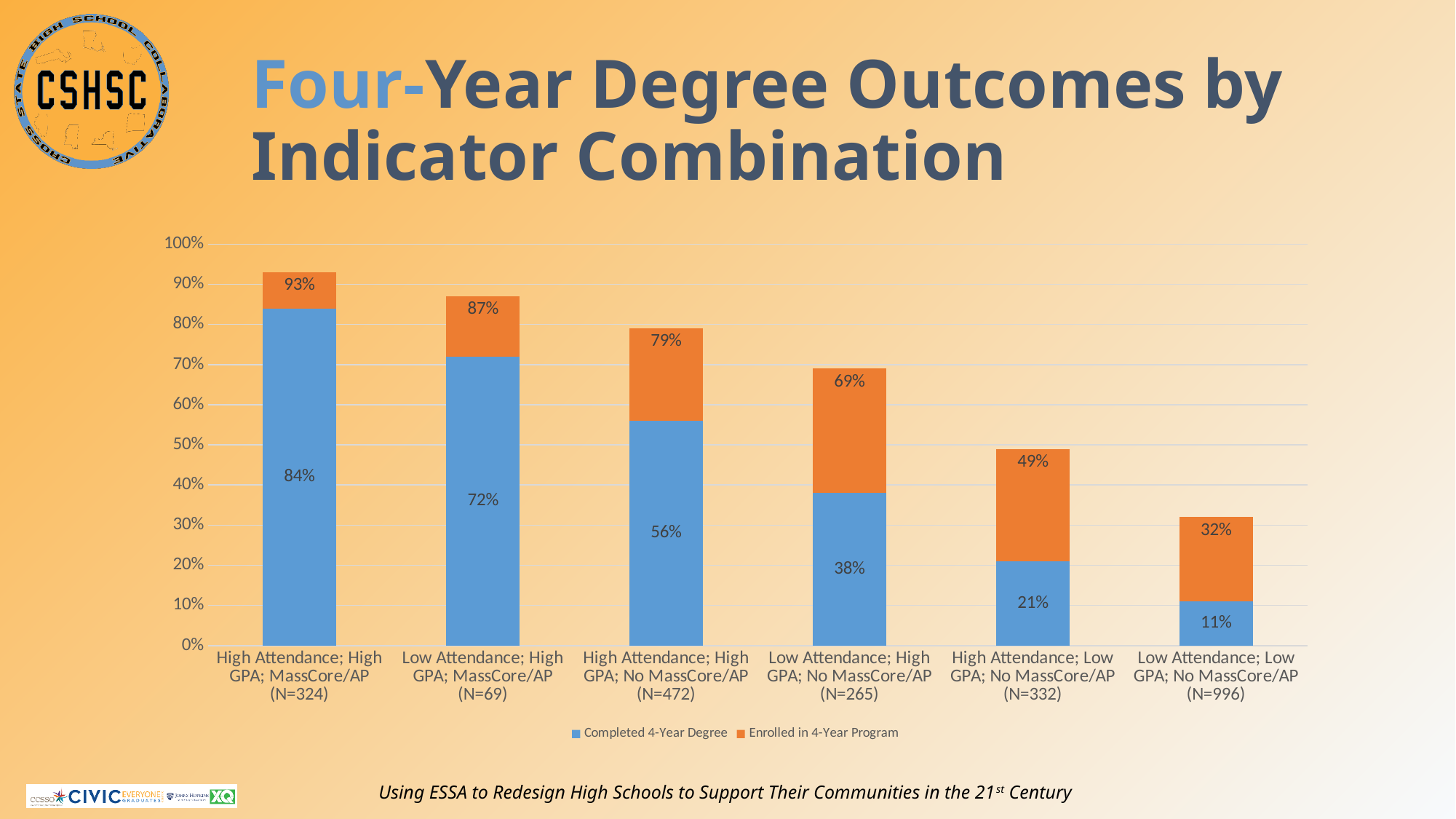
How many series does the legend list? 2 How many indicator combination categories are shown on the x axis? 6 Do the total bar heights rise or fall moving from left to right across the x axis? Fall Which group has a larger Completed 4-Year Degree percentage: High Attendance; Low GPA; No MassCore/AP (N=332) or Low Attendance; High GPA; No MassCore/AP (N=265)? Low Attendance; High GPA; No MassCore/AP (N=265) Which indicator combination has the highest percentage of students who completed a 4-year degree? High Attendance; High GPA; MassCore/AP (N=324) What is the total height of the stacked bar for High Attendance; High GPA; No MassCore/AP (N=472)? 79% What percentage of the Low Attendance; High GPA; MassCore/AP (N=69) group completed a 4-year degree? 72% What kind of chart is shown on the slide? Stacked bar chart What percentage of the Low Attendance; Low GPA; No MassCore/AP (N=996) group completed a 4-year degree? 11% Which indicator combination has the lowest percentage of students who completed a 4-year degree? Low Attendance; Low GPA; No MassCore/AP (N=996) What percentage of the High Attendance; High GPA; MassCore/AP (N=324) group completed a 4-year degree? 84% What is the difference between the Completed 4-Year Degree percentages for High Attendance; High GPA; No MassCore/AP (N=472) and Low Attendance; High GPA; No MassCore/AP (N=265)? 18%